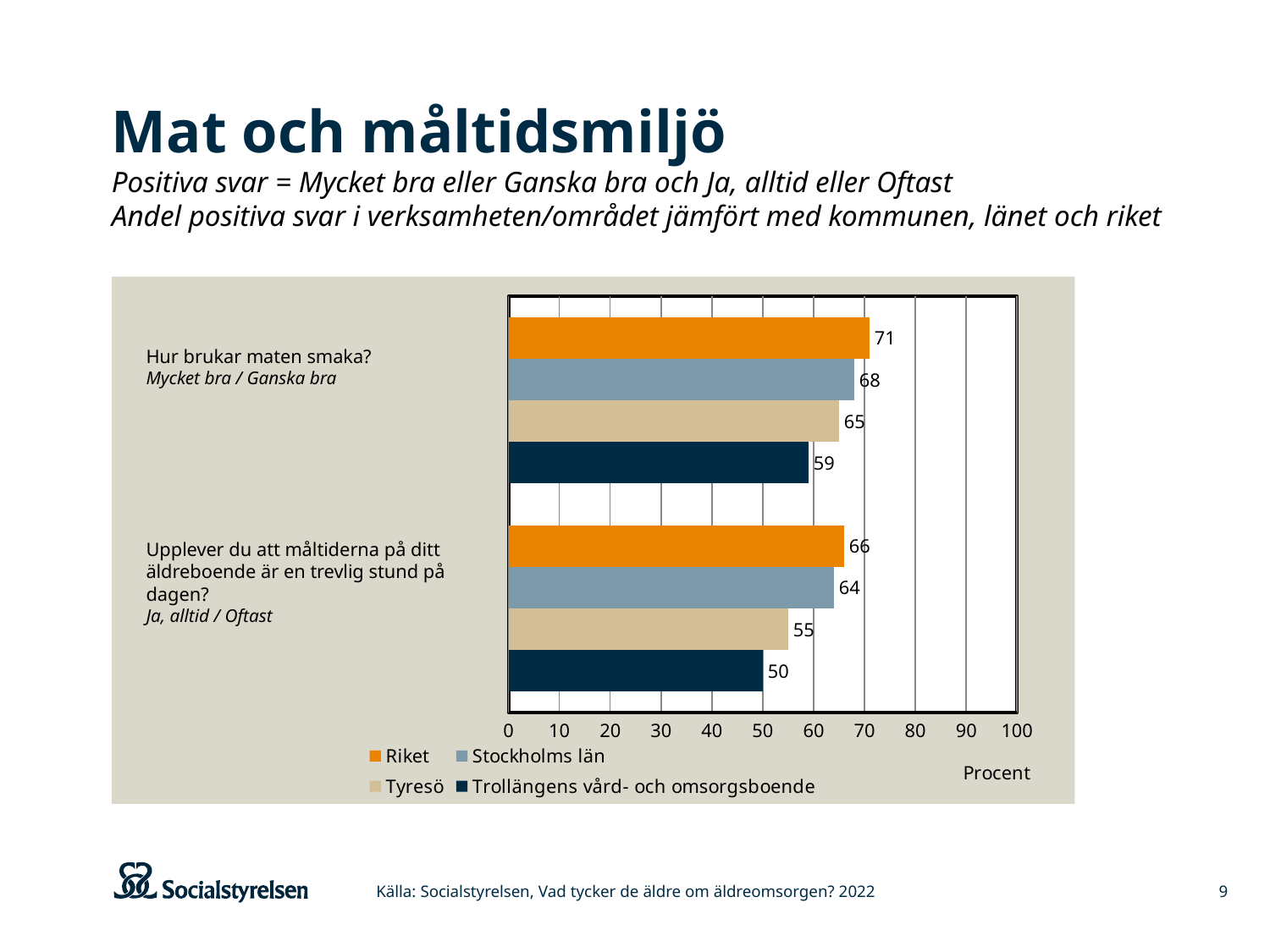
What kind of chart is shown on the slide? Bar chart What is the value for Stockholms län for the question 'Upplever du att måltiderna på ditt äldreboende är en trevlig stund på dagen?' 64 What is the value for Trollängens vård- och omsorgsboende for the question 'Upplever du att måltiderna på ditt äldreboende är en trevlig stund på dagen?' 50 What is the difference between Tyresö and Trollängens vård- och omsorgsboende for the question 'Upplever du att måltiderna på ditt äldreboende är en trevlig stund på dagen?' 5 Which series has the lowest value for the question 'Upplever du att måltiderna på ditt äldreboende är en trevlig stund på dagen?' Trollängens vård- och omsorgsboende How many series does the legend list? 4 Which is larger: Tyresö for 'Hur brukar maten smaka?' or Tyresö for 'Upplever du att måltiderna på ditt äldreboende är en trevlig stund på dagen?' Hur brukar maten smaka? What is the value for Riket for the question 'Hur brukar maten smaka?' 71 What unit label is shown on the x axis? Procent Which series has the highest value for the question 'Hur brukar maten smaka?' Riket What is the value for Tyresö for the question 'Hur brukar maten smaka?' 65 What is the difference between Riket and Trollängens vård- och omsorgsboende for the question 'Hur brukar maten smaka?' 12